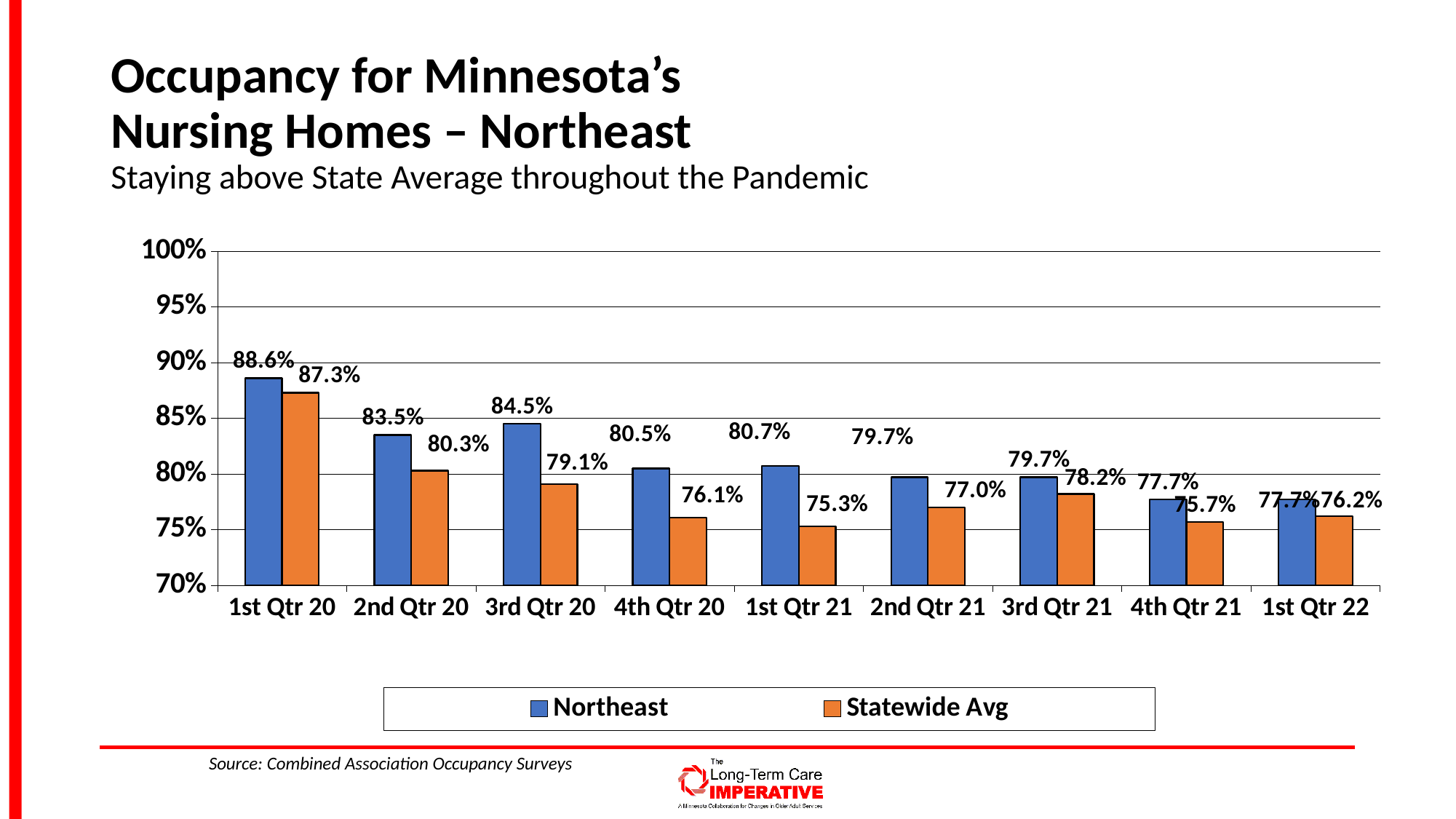
In which quarter is the Statewide Avg occupancy lowest? 1st Qtr 21 In which quarter is the Northeast occupancy highest? 1st Qtr 20 What kind of chart is shown on the slide? Bar chart What is the Northeast value for 4th Qtr 21? 77.7% What is the Statewide Avg value for 1st Qtr 21? 75.3% What is the Statewide Avg value for 3rd Qtr 20? 79.1% What is the difference between the Northeast and Statewide Avg values in 3rd Qtr 20? 5.4% How many series does the legend list? 2 What is the Northeast occupancy value for 1st Qtr 20? 88.6% Does the Northeast occupancy generally rise or fall from 1st Qtr 20 to 1st Qtr 22? Fall Which is larger in 2nd Qtr 21, the Northeast value or the Statewide Avg value? Northeast How many quarters are shown on the x axis? 9